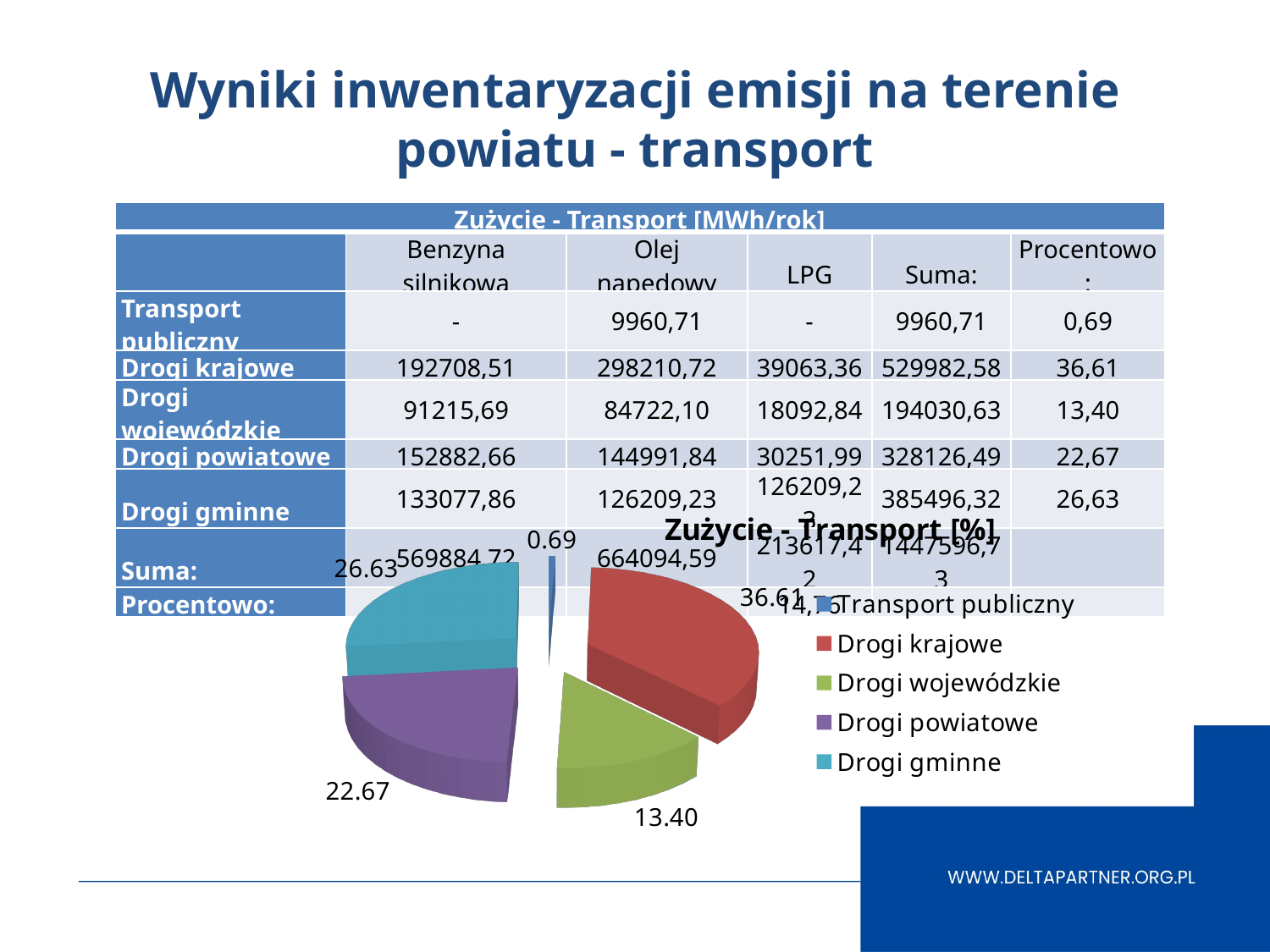
What is the title of the pie chart? Zużycie - Transport [%] How many slices does the pie chart have? 5 What value is shown for Drogi wojewódzkie in the pie chart? 13.40 Which category has the largest slice in the pie chart? Drogi krajowe In the pie chart, which is larger: Drogi gminne or Drogi powiatowe? Drogi gminne What value is shown for Drogi powiatowe in the pie chart? 22.67 Which category has the smallest slice in the pie chart? Transport publiczny What value is shown for Transport publiczny in the pie chart? 0.69 What kind of chart is shown on the slide? pie chart What value is shown for Drogi gminne in the pie chart? 26.63 How many entries does the legend of the pie chart list? 5 What value is shown for Drogi krajowe in the pie chart? 36.61